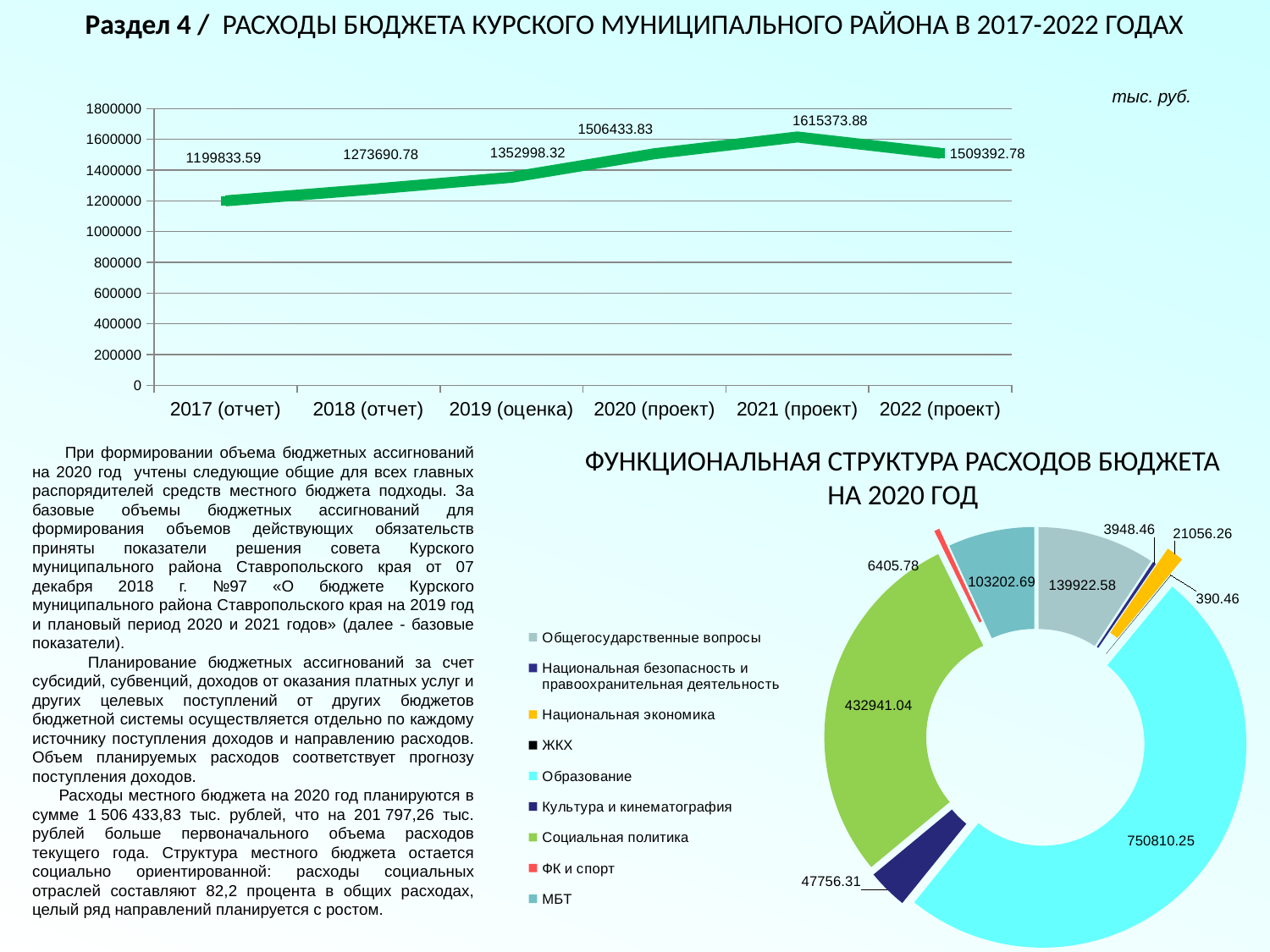
On the chart 'ФУНКЦИОНАЛЬНАЯ СТРУКТУРА РАСХОДОВ БЮДЖЕТА НА 2020 ГОД', what is the value for Образование? 750810.25 On the top line chart, which year has the lowest value? 2017 (отчет) On the top line chart, is the value for 2019 (оценка) greater or less than 1400000? less On the top line chart, do the values rise or fall from 2017 (отчет) to 2021 (проект)? rise On the chart 'ФУНКЦИОНАЛЬНАЯ СТРУКТУРА РАСХОДОВ БЮДЖЕТА НА 2020 ГОД', how many categories does the legend list? 9 On the chart 'ФУНКЦИОНАЛЬНАЯ СТРУКТУРА РАСХОДОВ БЮДЖЕТА НА 2020 ГОД', which category has the smallest value? ЖКХ On the chart 'ФУНКЦИОНАЛЬНАЯ СТРУКТУРА РАСХОДОВ БЮДЖЕТА НА 2020 ГОД', which is larger: Социальная политика or МБТ? Социальная политика On the top line chart, what is the difference between the values for 2021 (проект) and 2020 (проект)? 108940.05 On the top line chart, what is the value for 2017 (отчет)? 1199833.59 On the top line chart, what is the value for 2020 (проект)? 1506433.83 On the top line chart, how many years are plotted? 6 On the top line chart, which year has the highest value? 2021 (проект)